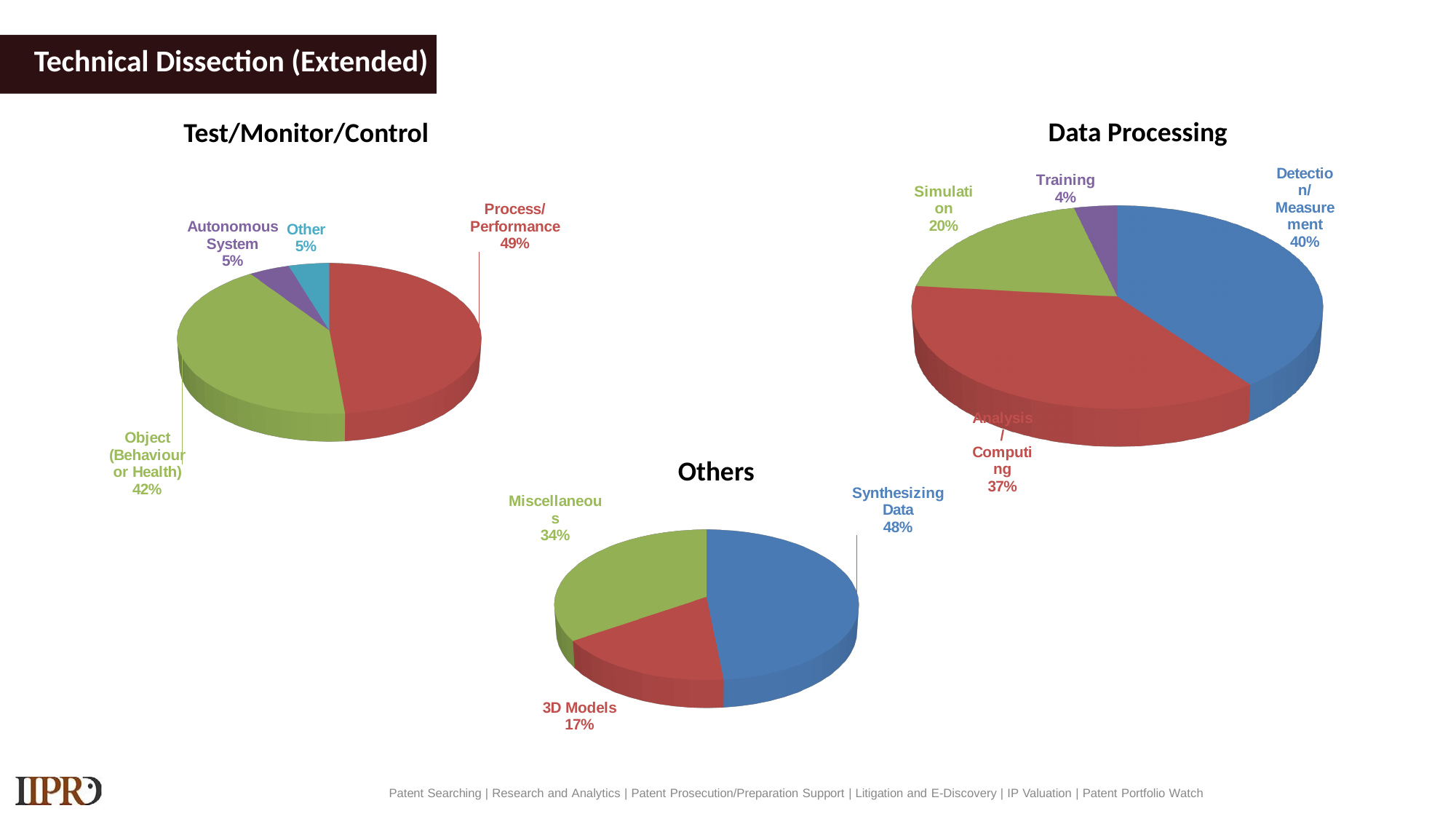
How many charts are shown on the slide? 3 What type of chart is used for the Others chart? Pie chart In the Test/Monitor/Control chart, which category has the largest share? Process/Performance In the Others chart, what is the difference between Miscellaneous and 3D Models? 17% In the Test/Monitor/Control chart, what is the share for Object (Behaviour or Health)? 42% In the Data Processing chart, what is the difference between the Detection/Measurement and Analysis/Computing shares? 3% In the Data Processing chart, which is larger, Simulation or Training? Simulation In the Data Processing chart, which category has the smallest share? Training In the Others chart, what share does Synthesizing Data have? 48% In the Test/Monitor/Control chart, how many slices does the pie have? 4 In the Data Processing chart, what share does Detection/Measurement have? 40% In the Test/Monitor/Control chart, what share does Process/Performance have? 49%